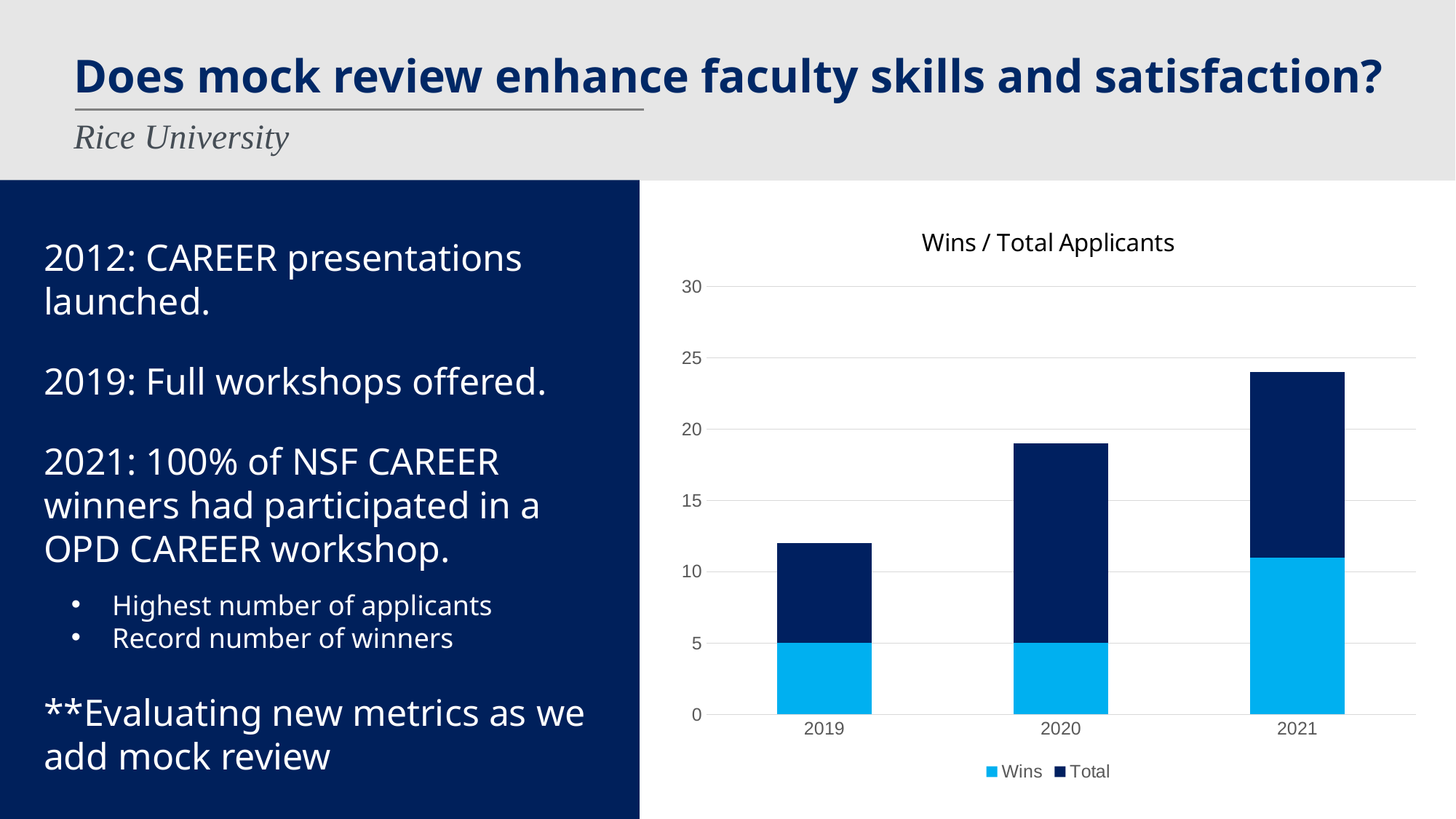
How many series does the chart legend list? 2 What kind of chart is shown on the slide? bar chart How many years are shown on the x axis of the chart? 3 Which year has the larger Wins value, 2019 or 2021? 2021 What is the title of the chart? Wins / Total Applicants Which year has the tallest stacked bar? 2021 Is the top of the stacked bar for 2021 greater or less than 20? greater What is the value of Wins for 2019? 5 Is the value of Wins for 2021 greater or less than 10? greater What is the value of Wins for 2020? 5 Do the stacked bar heights rise or fall from 2019 to 2021? rise Is the top of the stacked bar for 2019 greater or less than 15? less